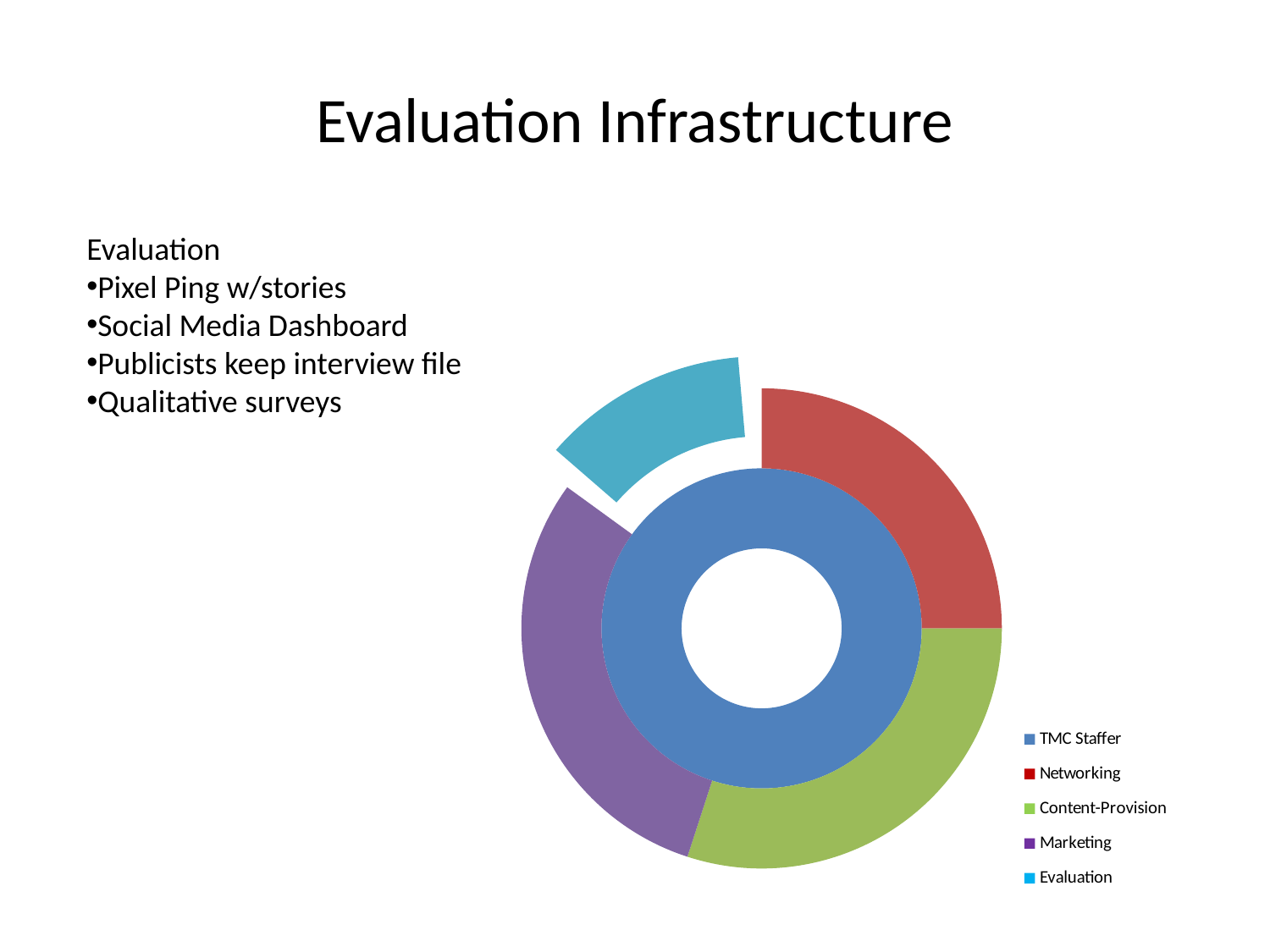
What kind of chart is shown on the slide? doughnut chart How many entries does the chart legend list? 5 Which slice of the chart is pulled out (exploded) from the ring? Evaluation Which legend entry is shown in blue on the chart? TMC Staffer Which is larger in the chart, the Networking slice or the Evaluation slice? Networking Which is larger in the chart, the Content-Provision slice or the Evaluation slice? Content-Provision Which is larger in the chart, the Marketing slice or the Evaluation slice? Marketing Which category in the outer ring of the chart has the smallest slice? Evaluation